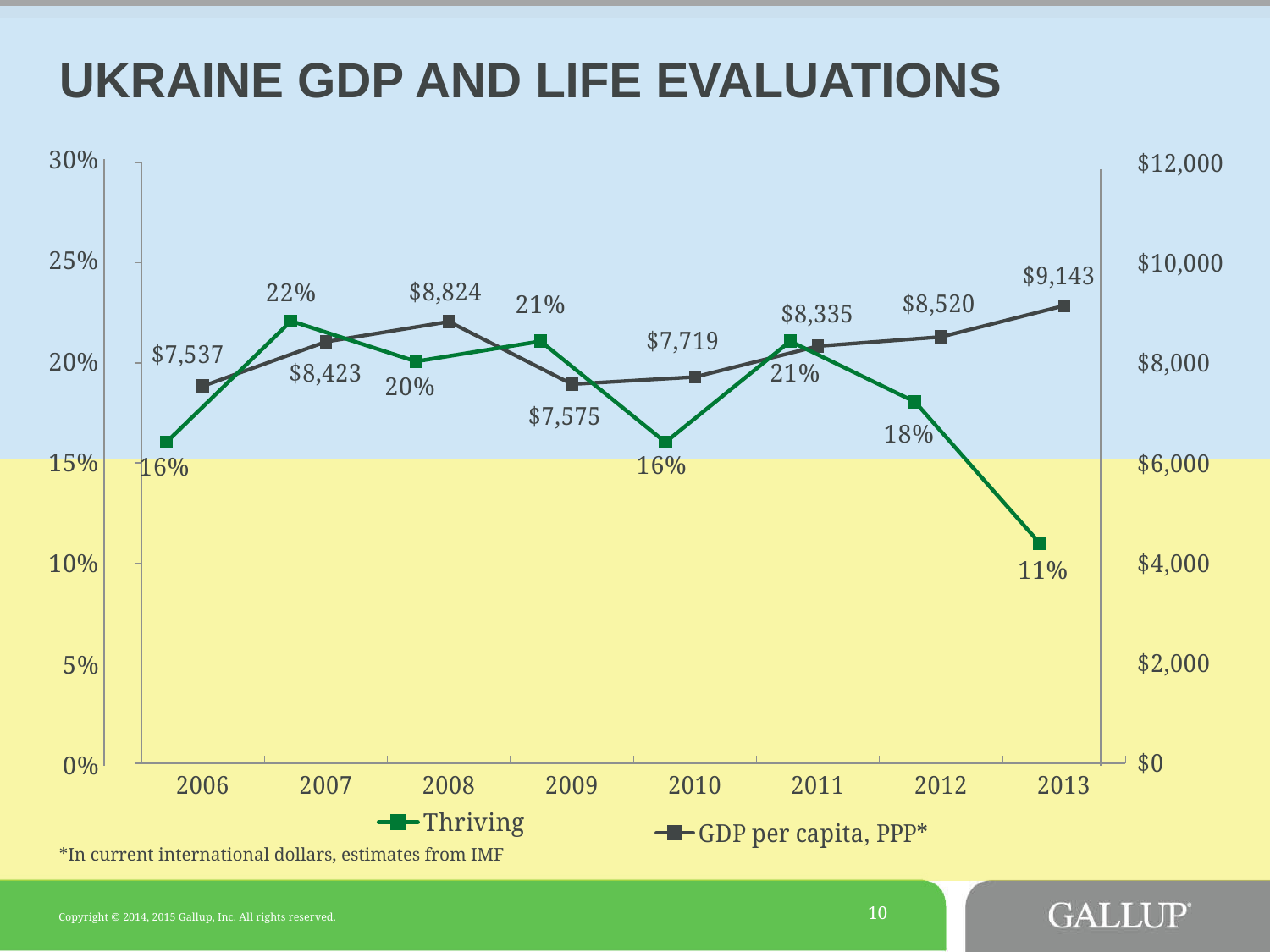
How many years are plotted on the x axis? 8 What was GDP per capita, PPP in 2013? $9,143 What kind of chart is shown on the slide? line chart In which year was GDP per capita, PPP lowest? 2006 By how many percentage points did the Thriving percentage fall from 2012 to 2013? 7 In which year was GDP per capita, PPP highest? 2013 What was GDP per capita, PPP in 2009? $7,575 How many series does the legend list? 2 In which year was the Thriving percentage lowest? 2013 Which is larger, GDP per capita, PPP in 2008 or in 2011? 2008 What was the Thriving percentage in 2007? 22% What is the difference in GDP per capita, PPP between 2013 and 2006? $1,606